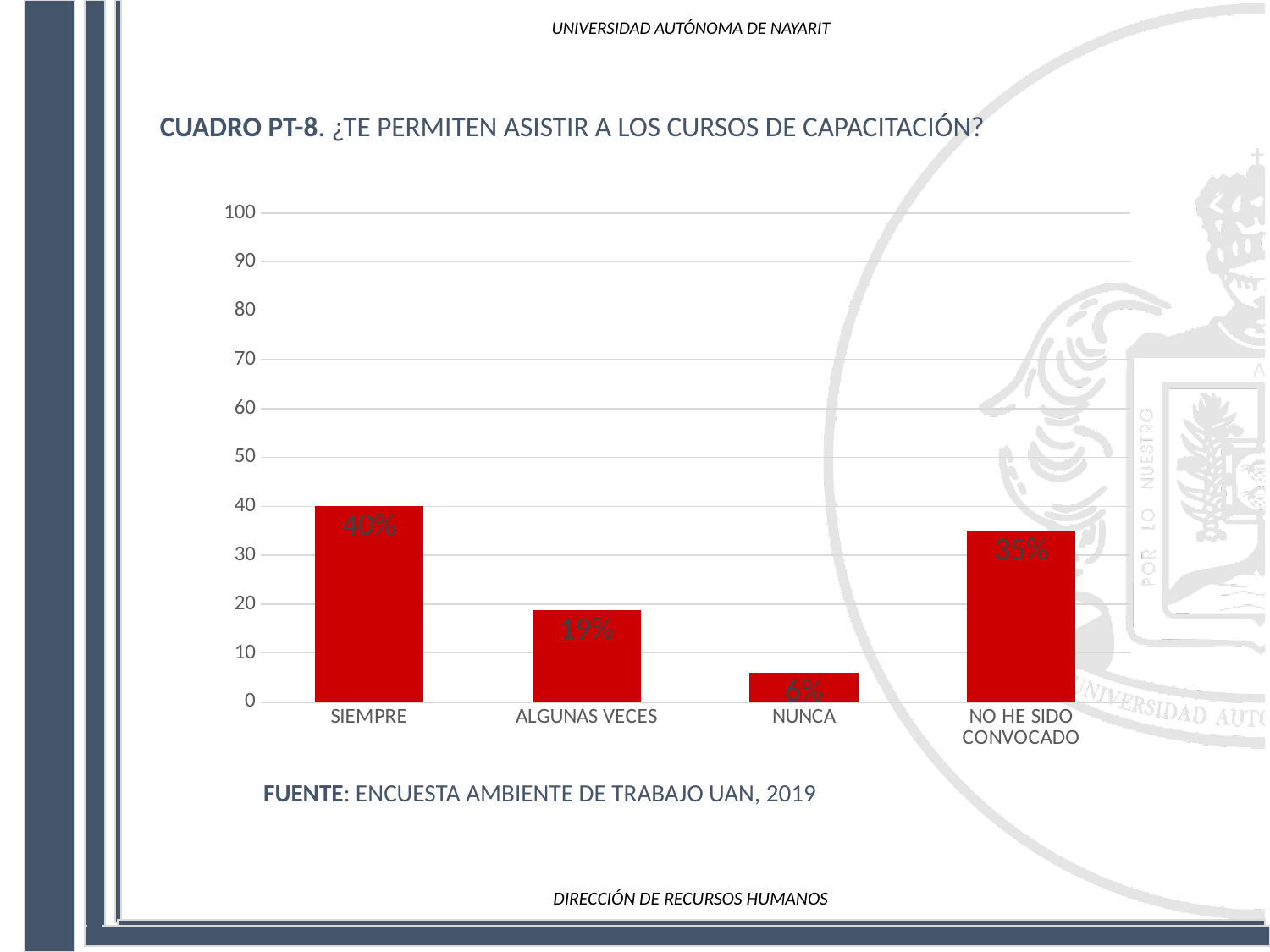
Which category has the highest value? SIEMPRE Which category has the lowest value? NUNCA Which is larger, the value for ALGUNAS VECES or the value for NO HE SIDO CONVOCADO? NO HE SIDO CONVOCADO What is the difference between the values for SIEMPRE and NO HE SIDO CONVOCADO? 5% What is the source cited below the chart? ENCUESTA AMBIENTE DE TRABAJO UAN, 2019 What is the difference between the values for ALGUNAS VECES and NUNCA? 13% What kind of chart is shown on the slide? bar chart How many categories are shown on the x axis? 4 What is the value for NO HE SIDO CONVOCADO? 35% What is the value for ALGUNAS VECES? 19% What is the value for NUNCA? 6% What is the value for SIEMPRE? 40%